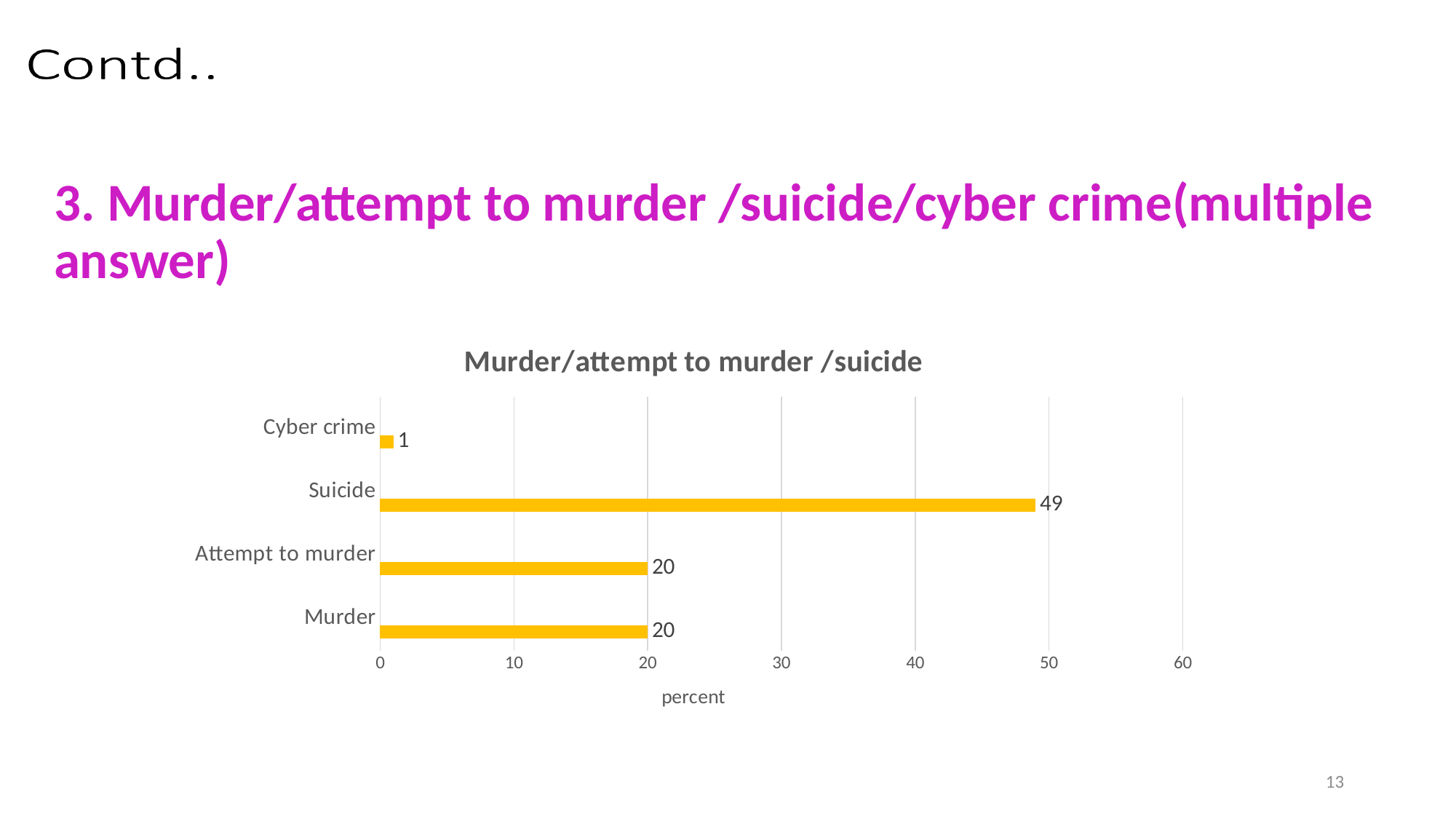
Which is larger, the value for Suicide or the value for Attempt to murder? Suicide Which category has the highest value? Suicide What is the value for Cyber crime? 1 Which category has the lowest value? Cyber crime How many categories are shown in the chart? 4 What is the difference between the values for Suicide and Murder? 29 What kind of chart is shown on the slide? Bar chart What is the value for Attempt to murder? 20 What is the difference between the values for Attempt to murder and Cyber crime? 19 What is the title of the chart? Murder/attempt to murder /suicide What is the value for Murder? 20 What is the value for Suicide? 49